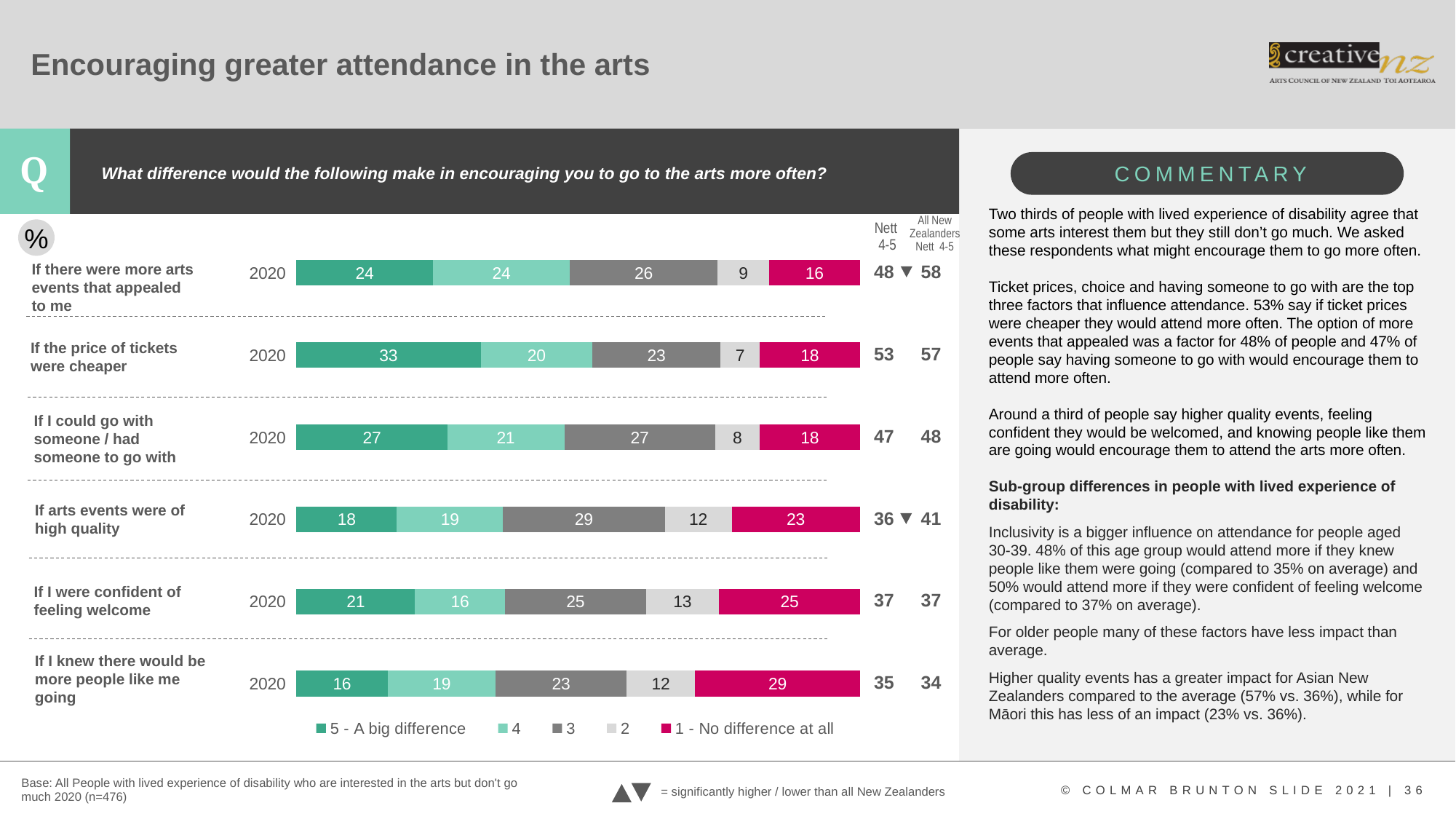
Which is larger: the '1 - No difference at all' value for 'If arts events were of high quality' or for 'If the price of tickets were cheaper'? If arts events were of high quality What is the difference between the Nett 4-5 value and the All New Zealanders Nett 4-5 value for 'If there were more arts events that appealed to me'? 10 How many series does the legend list? 5 Which statement has the highest '5 - A big difference' percentage? If the price of tickets were cheaper What is the 'All New Zealanders Nett 4-5' value for 'If there were more arts events that appealed to me'? 58 How many statements (categories) are shown in the chart? 6 What percentage of respondents said cheaper ticket prices would make '5 - A big difference'? 33 What type of chart is shown on the slide? Stacked bar chart What colour represents '1 - No difference at all' in the chart? Pink/magenta Which statement has the lowest Nett 4-5 value? If I knew there would be more people like me going What percentage said '1 - No difference at all' for 'If I knew there would be more people like me going'? 29 What is the Nett 4-5 value for 'If I could go with someone / had someone to go with'? 47